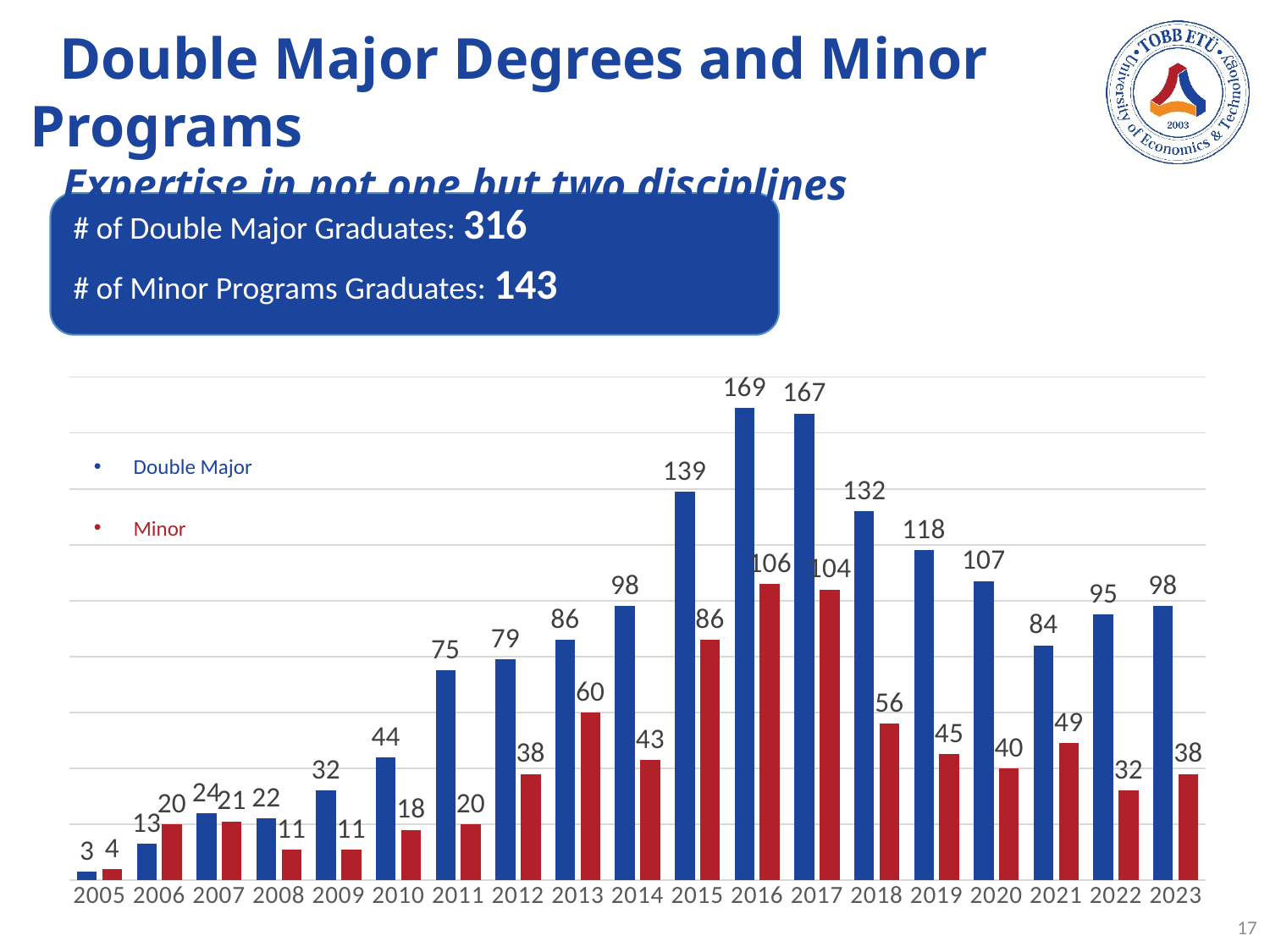
Which year has the highest Double Major value? 2016 What type of chart is shown on the slide? bar chart Do the Double Major values rise or fall from 2005 to 2016? rise What is the Double Major value for 2016? 169 Which year has the lowest Minor value? 2005 What is the Double Major value for 2023? 98 Which colour represents the Minor series in the chart? red Which is larger, the Minor value for 2021 or the Minor value for 2022? 2021 What is the Minor value for 2013? 60 What is the difference between the Double Major and Minor values in 2015? 53 How many years are shown on the x axis of the chart? 19 How many series does the chart's legend list? 2